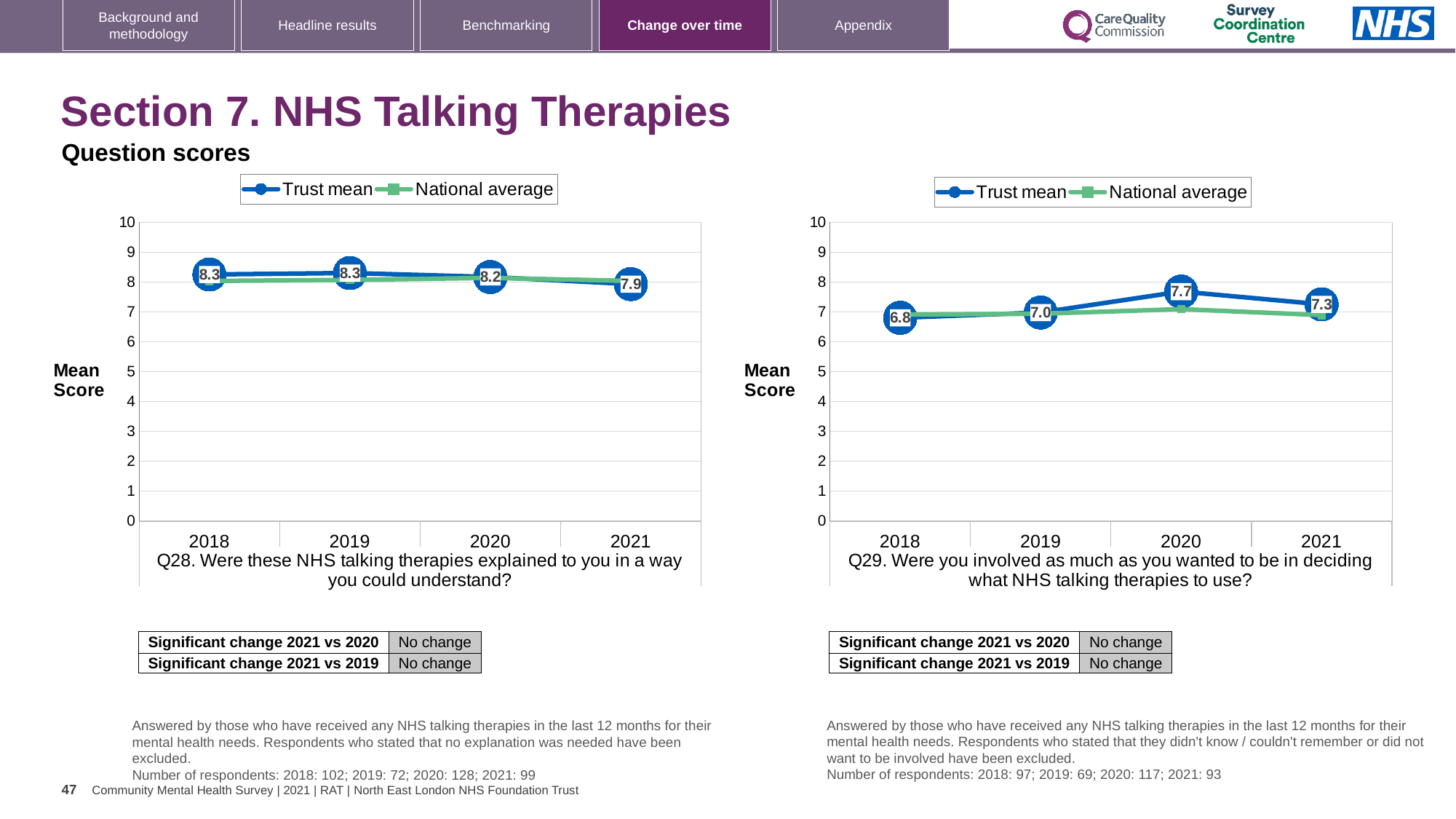
In the Q28 chart on the left, which year has the lowest Trust mean score? 2021 In the Q29 chart on the right, what is the difference between the Trust mean scores for 2020 and 2018? 0.9 In the Q29 chart on the right, which year has the highest Trust mean score? 2020 In the Q29 chart on the right, which year has the lowest Trust mean score? 2018 In the Q28 chart on the left, is the National average for 2018 greater or less than 7? greater In the Q28 chart on the left, what is the Trust mean score for 2021? 7.9 In the Q28 chart on the left, is the Trust mean score higher in 2020 or in 2021? 2020 How many series does the legend of the Q28 chart on the left list? 2 In the Q29 chart on the right, what is the Trust mean score for 2020? 7.7 What kind of chart is the Q29 chart on the right? Line chart In the Q29 chart on the right, is the National average for 2020 greater or less than 8? less In the Q28 chart on the left, what is the difference between the Trust mean scores for 2018 and 2021? 0.4